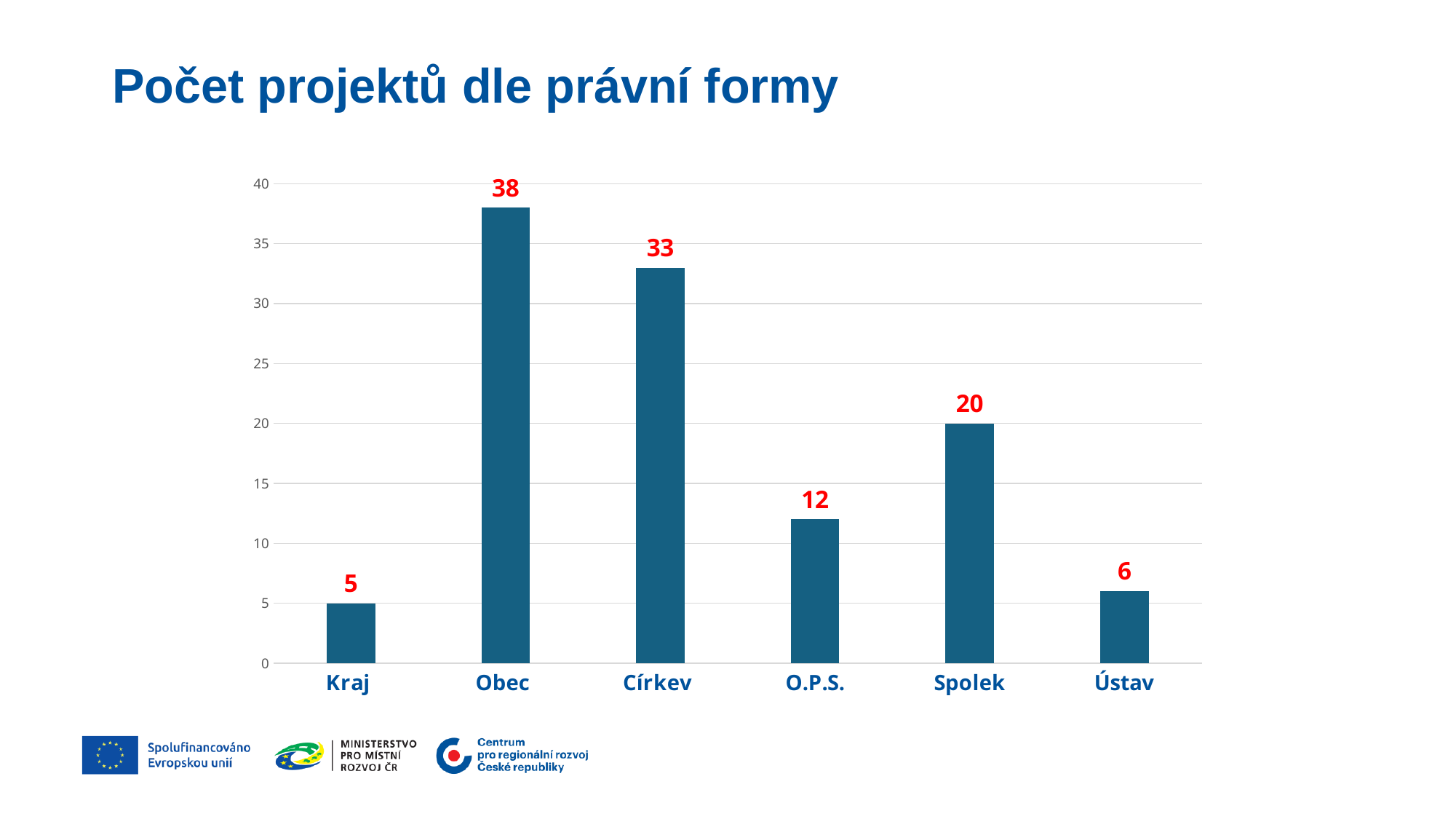
What is the value for Ústav? 6 What is the difference between the values for Obec and Církev? 5 What is the value for Církev? 33 What is the value for Obec? 38 What is the title of the slide? Počet projektů dle právní formy What is the value for Spolek? 20 Which is larger, the value for O.P.S. or the value for Ústav? O.P.S. Which category has the lowest value? Kraj What is the difference between the values for Spolek and O.P.S.? 8 What kind of chart is shown on the slide? Bar chart Which category has the highest value? Obec How many categories are shown on the x axis? 6